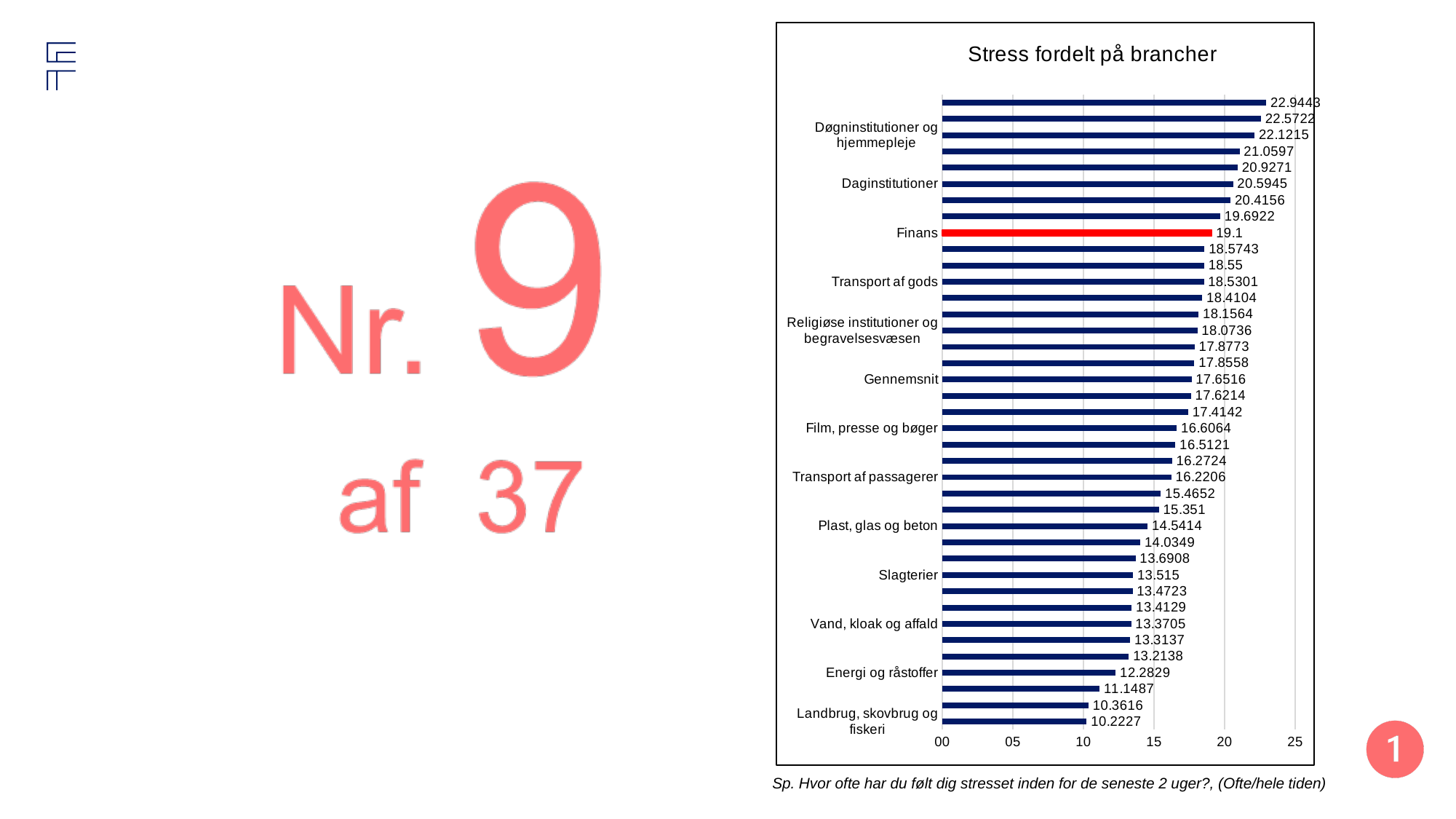
What is the highest value shown in the chart? 22.9443 What is the value for Gennemsnit in the chart? 17.6516 What is the difference between the value for Finans and the value for Gennemsnit? 1.4484 Is the value for Slagterier greater or less than 15? less Which is larger, the value for Finans or the value for Transport af gods? Finans What is the value for Daginstitutioner? 20.5945 What is the value for Finans in the chart? 19.1 What is the value for Energi og råstoffer? 12.2829 What is the value for Landbrug, skovbrug og fiskeri? 10.2227 Which labelled category has the lowest value in the chart? Landbrug, skovbrug og fiskeri Which category's bar is highlighted in red? Finans What kind of chart is shown on the slide? Bar chart